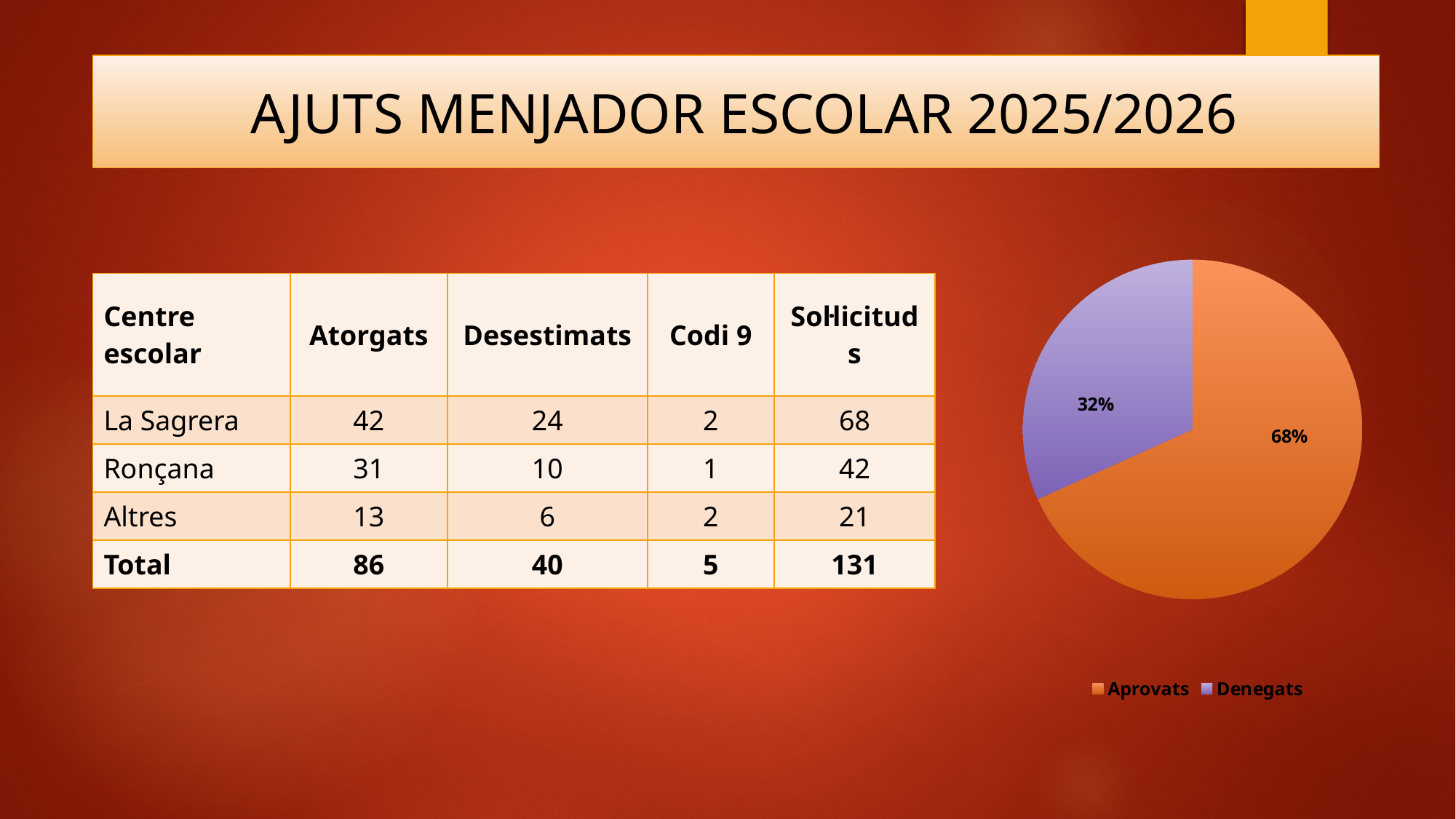
Which slice of the pie chart is the smallest? Denegats What kind of chart is shown on the right of the slide? Pie chart What share of the pie chart is labelled Denegats? 32% In the pie chart, which is larger: Aprovats or Denegats? Aprovats How many slices does the pie chart have? 2 What colour is the Denegats slice in the pie chart? Purple What colour is the Aprovats slice in the pie chart? Orange What is the combined share of the Aprovats and Denegats slices in the pie chart? 100% Which slice of the pie chart is the largest? Aprovats By how many percentage points does the Aprovats slice exceed the Denegats slice in the pie chart? 36 percentage points What share of the pie chart is labelled Aprovats? 68% How many entries does the legend of the pie chart list? 2